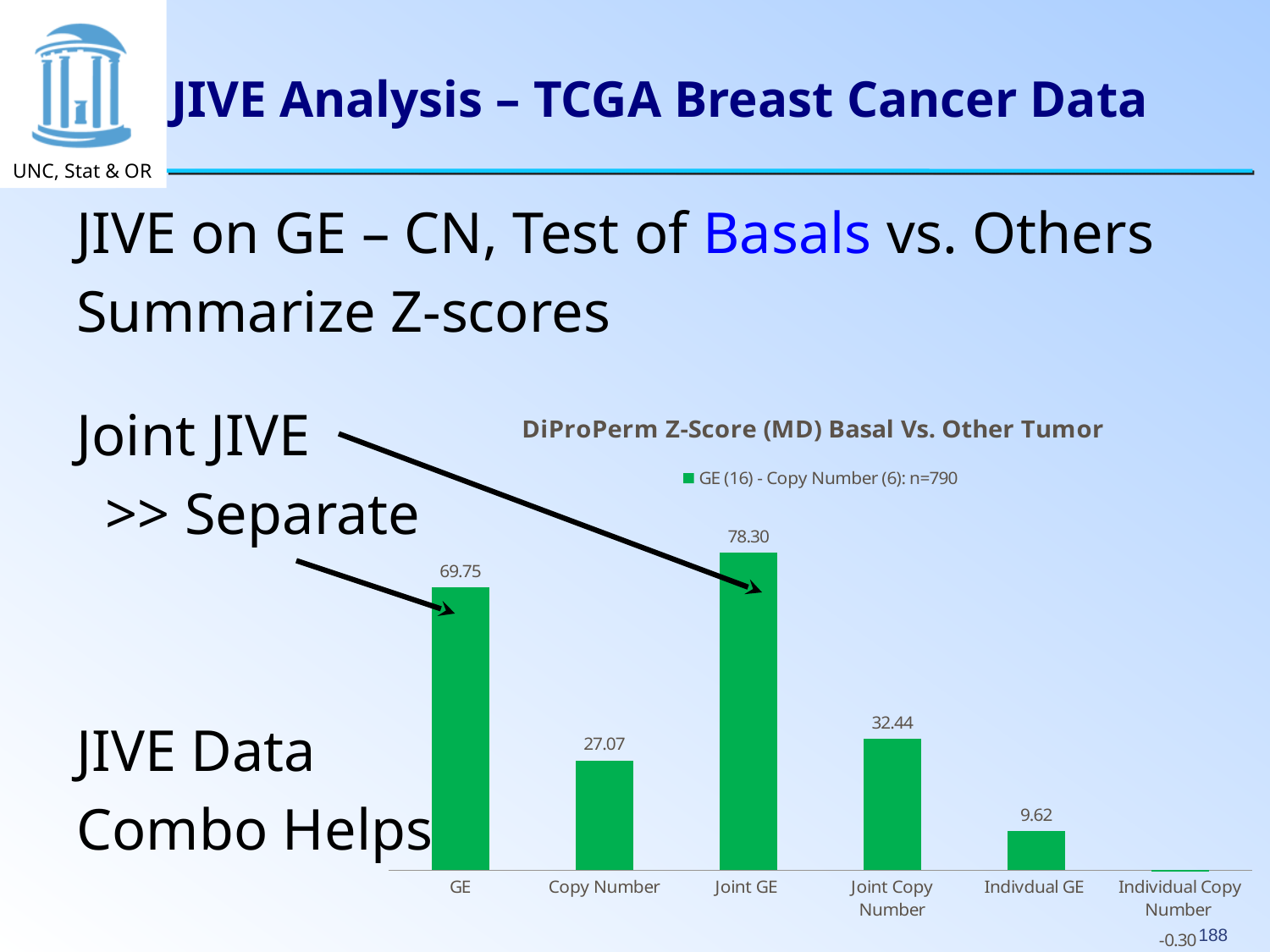
What is the difference between the Z-scores for Joint Copy Number and Indivdual GE? 22.82 What is the difference between the Z-scores for Joint GE and GE? 8.55 What is the Z-score value for Individual Copy Number? -0.30 Which category has the lowest Z-score? Individual Copy Number What kind of chart is shown on the slide? Bar chart What is the Z-score value for Joint Copy Number? 32.44 What is the title of the chart? DiProPerm Z-Score (MD) Basal Vs. Other Tumor What is the Z-score value for Joint GE? 78.30 What is the Z-score value for Copy Number? 27.07 Which has a larger Z-score, Copy Number or Joint Copy Number? Joint Copy Number How many categories are shown on the x axis of the chart? 6 Which category has the highest Z-score? Joint GE